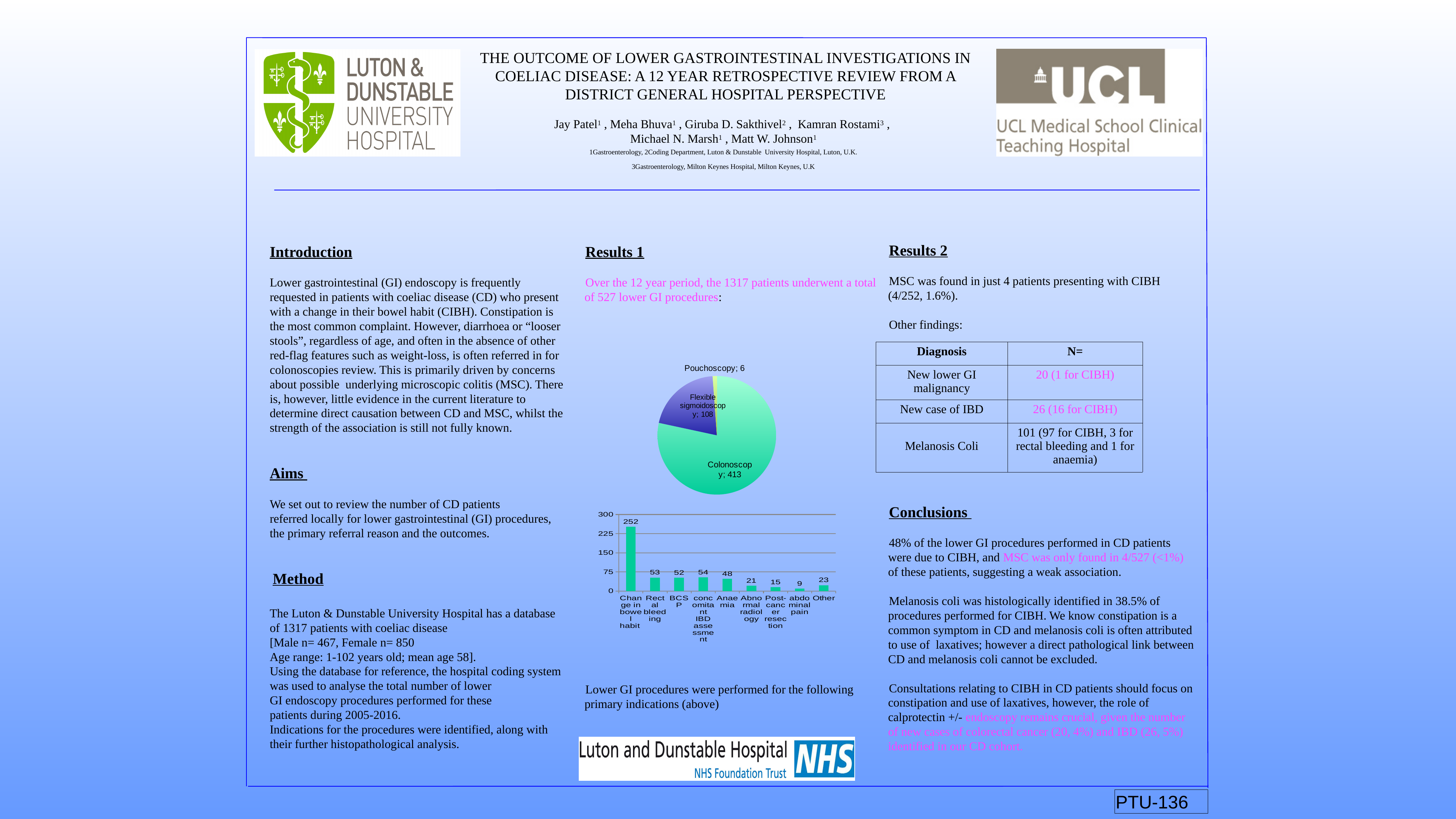
In the pie chart, what is the value for Flexible sigmoidoscopy? 108 In the pie chart, what is the difference between the Colonoscopy and Flexible sigmoidoscopy values? 305 What type of chart is the lower chart in the Results 1 section? Bar chart In the bar chart, what is the difference between Change in bowel habit and Rectal bleeding? 199 In the pie chart, how many colonoscopies were performed? 413 In the pie chart, how many slices are there? 3 What type of chart is the upper chart in the Results 1 section? Pie chart In the bar chart, how many indication categories are shown? 9 In the bar chart, which is larger: Anaemia or Abnormal radiology? Anaemia In the bar chart, what is the value for Change in bowel habit? 252 In the pie chart, which procedure has the smallest slice? Pouchoscopy In the bar chart, which indication has the lowest value? abdominal pain